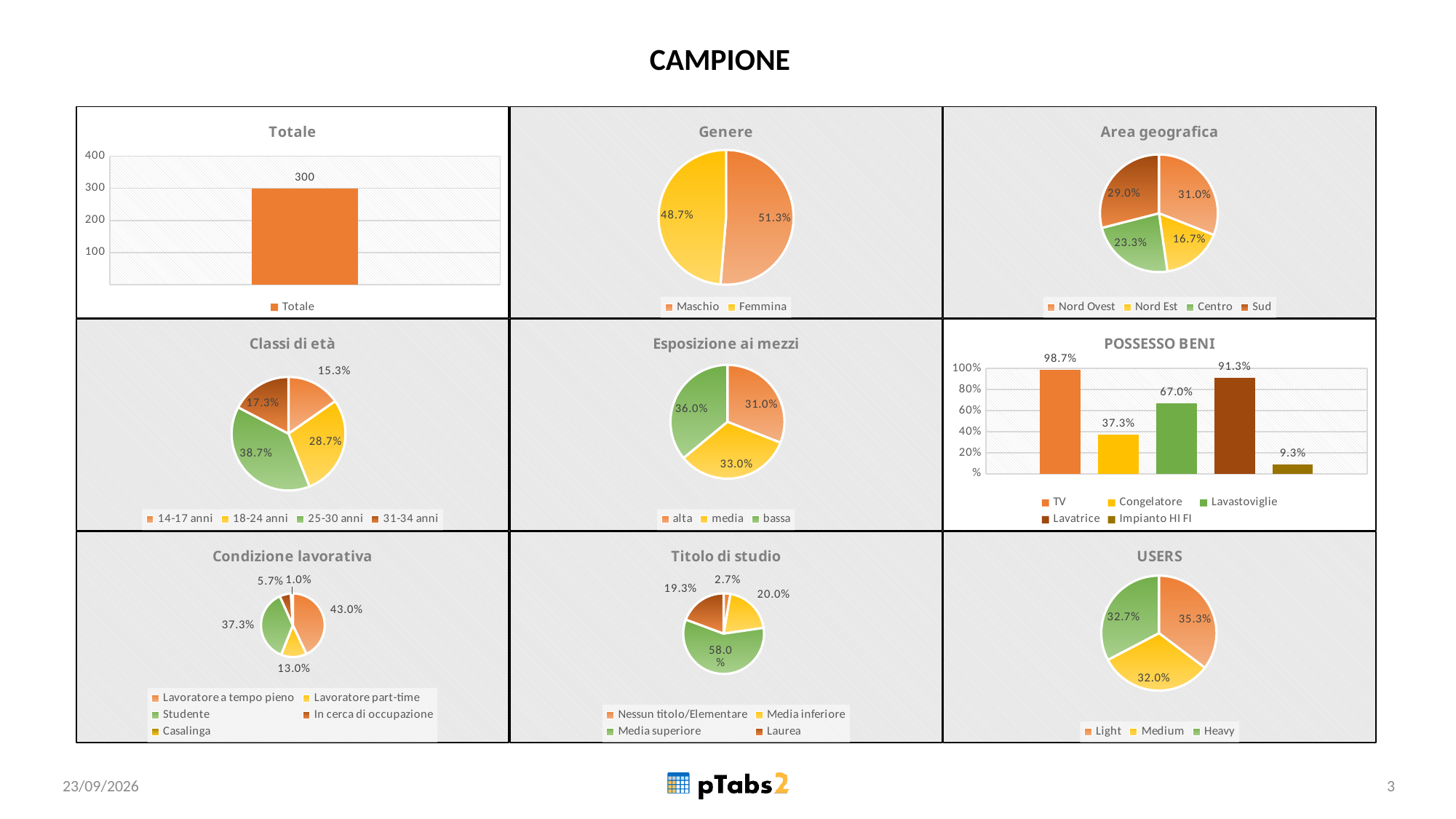
In the 'POSSESSO BENI' chart, which is larger, Congelatore or Lavastoviglie? Lavastoviglie In the 'POSSESSO BENI' chart, how many series does the legend list? 5 In the 'Area geografica' pie chart, which area has the smallest share? Nord Est In the 'Classi di età' pie chart, which age class has the largest share? 25-30 anni In the 'Genere' pie chart, what share is Femmina? 48.7% In the 'Totale' chart, what value is shown for Totale? 300 In the 'POSSESSO BENI' chart, what is the value for Lavatrice? 91.3% In the 'Esposizione ai mezzi' pie chart, what share is 'media'? 33.0% In the 'Titolo di studio' pie chart, how many categories are shown? 4 In the 'Condizione lavorativa' pie chart, what share is Studente? 37.3% What kind of chart is the 'Totale' chart? bar chart In the 'Area geografica' pie chart, what is the difference between Nord Ovest and Sud? 2.0%